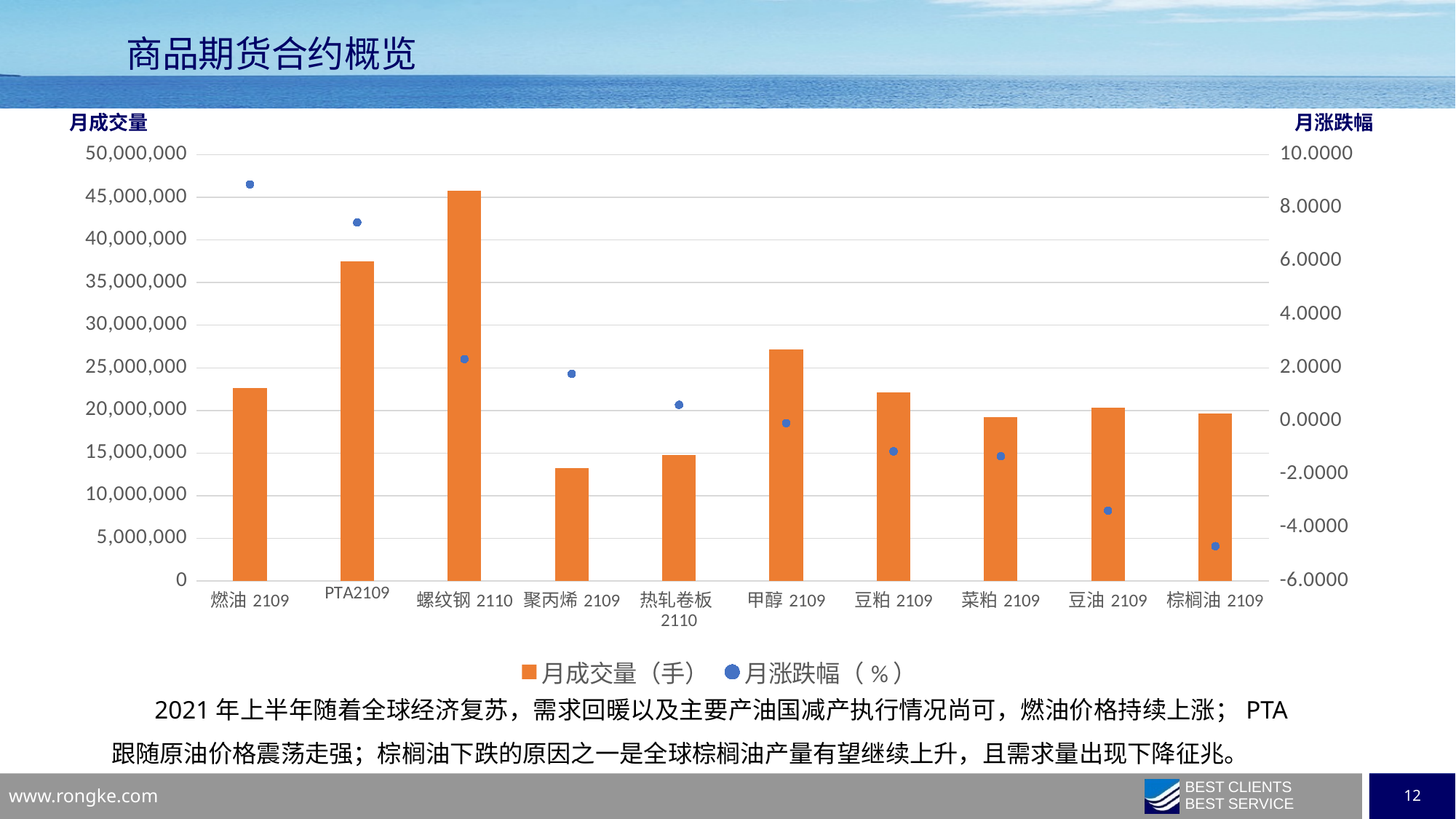
Which category has the highest 月涨跌幅 marker? 燃油 2109 Is the 月成交量 value for 螺纹钢 2110 greater or less than 40,000,000? greater Is the 月成交量 value for 聚丙烯 2109 greater or less than 15,000,000? less Which category has the lowest 月成交量 bar? 聚丙烯 2109 How many series does the legend list? 2 Which category has the highest 月成交量 bar? 螺纹钢 2110 Is the 月涨跌幅 value for 棕榈油 2109 greater or less than -4.0000? less How many categories are shown on the x axis? 10 Which has the larger 月成交量, PTA2109 or 甲醇 2109? PTA2109 Do the 月涨跌幅 markers generally rise or fall from left to right along the x axis? fall Which category has the lowest 月涨跌幅 marker? 棕榈油 2109